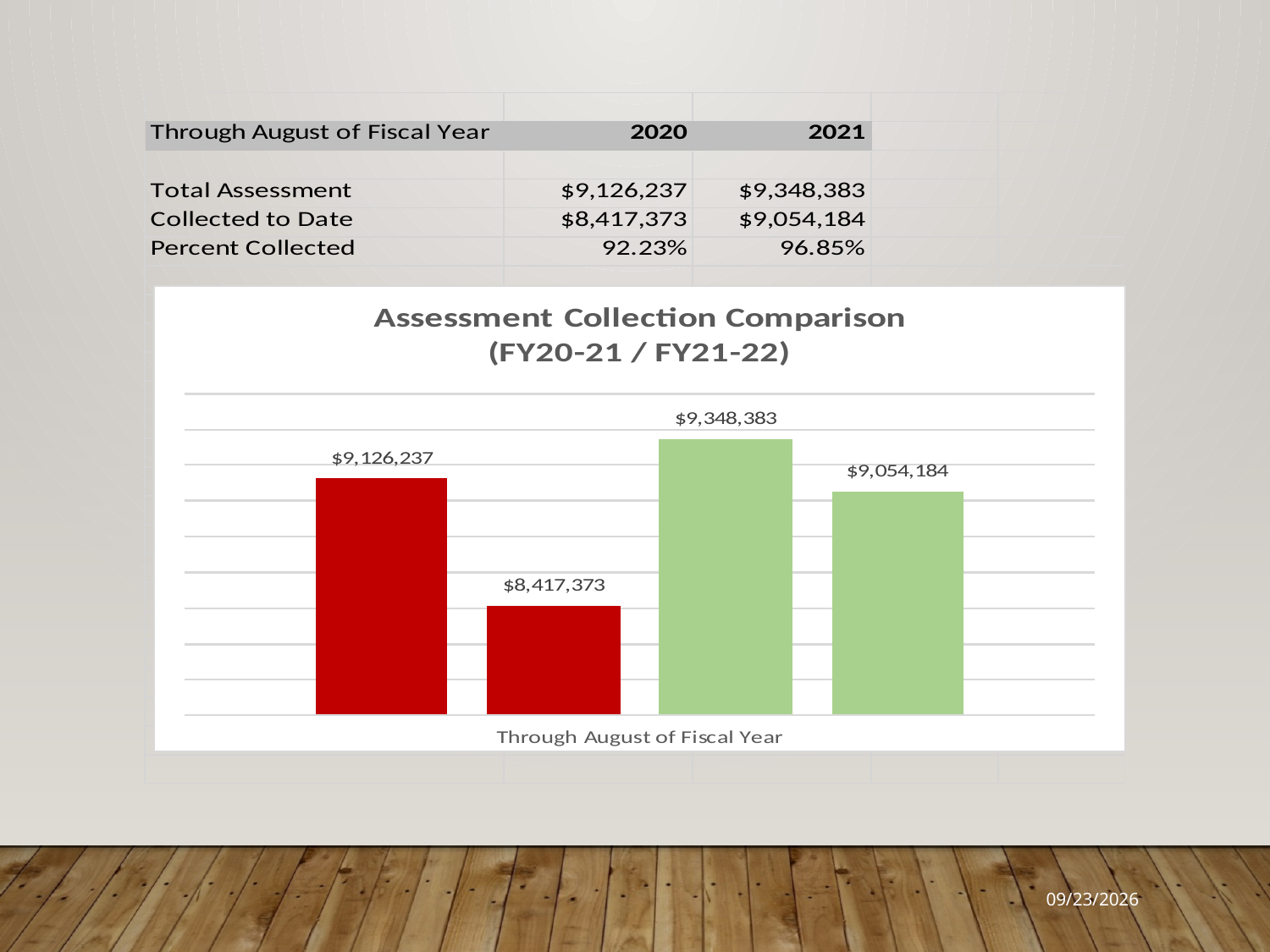
What is the title of the chart? Assessment Collection Comparison (FY20-21 / FY21-22) What is the value shown on the third bar of the chart? $9,348,383 How many bars are plotted in the chart? 4 Which bar in the chart has the highest value? The third bar ($9,348,383) What is the value shown on the first (leftmost) bar of the chart? $9,126,237 What is the difference between the first bar ($9,126,237) and the second bar ($8,417,373)? $708,864 What is the difference between the third bar ($9,348,383) and the fourth bar ($9,054,184)? $294,199 Which is larger, the value of the first bar or the value of the third bar? The third bar ($9,348,383) What is the value shown on the fourth (rightmost) bar of the chart? $9,054,184 What kind of chart is shown on the slide? Bar chart Which bar in the chart has the lowest value? The second bar ($8,417,373) What is the value shown on the second bar of the chart? $8,417,373